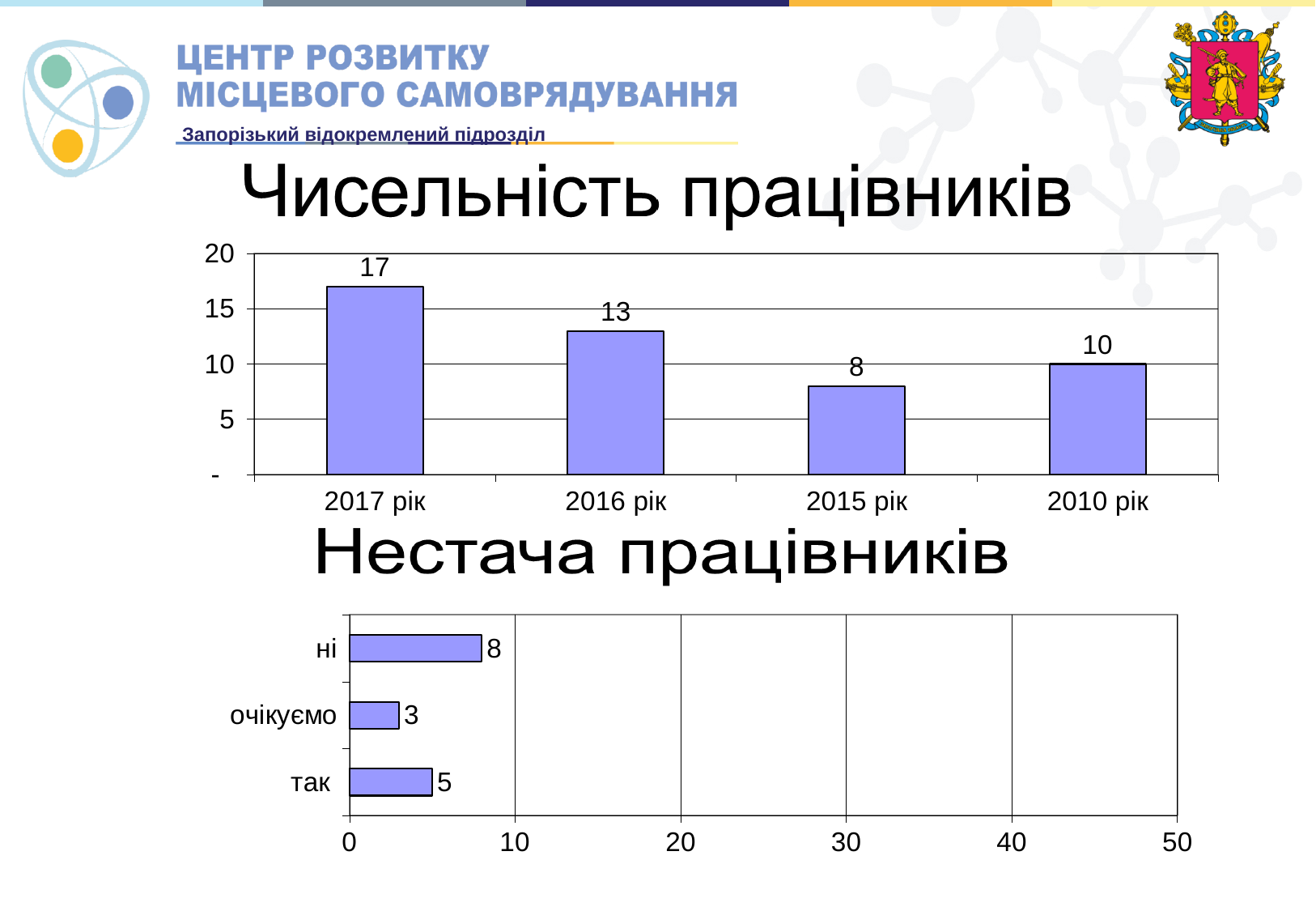
In the chart titled "Нестача працівників", what is the value for "так"? 5 In the chart titled "Чисельність працівників", which is larger: the value for 2010 рік or the value for 2015 рік? 2010 рік In the chart titled "Нестача працівників", what is the difference between the values for "ні" and "так"? 3 In the chart titled "Чисельність працівників", how many categories are shown on the x axis? 4 In the chart titled "Чисельність працівників", which category has the lowest value? 2015 рік In the chart titled "Чисельність працівників", what is the value for 2015 рік? 8 In the chart titled "Нестача працівників", which category has the highest value? ні In the chart titled "Чисельність працівників", which category has the highest value? 2017 рік In the chart titled "Чисельність працівників", what is the difference between the values for 2017 рік and 2016 рік? 4 In the chart titled "Нестача працівників", what is the value for "очікуємо"? 3 In the chart titled "Чисельність працівників", what is the value for 2017 рік? 17 What kind of chart is the one titled "Нестача працівників"? Bar chart